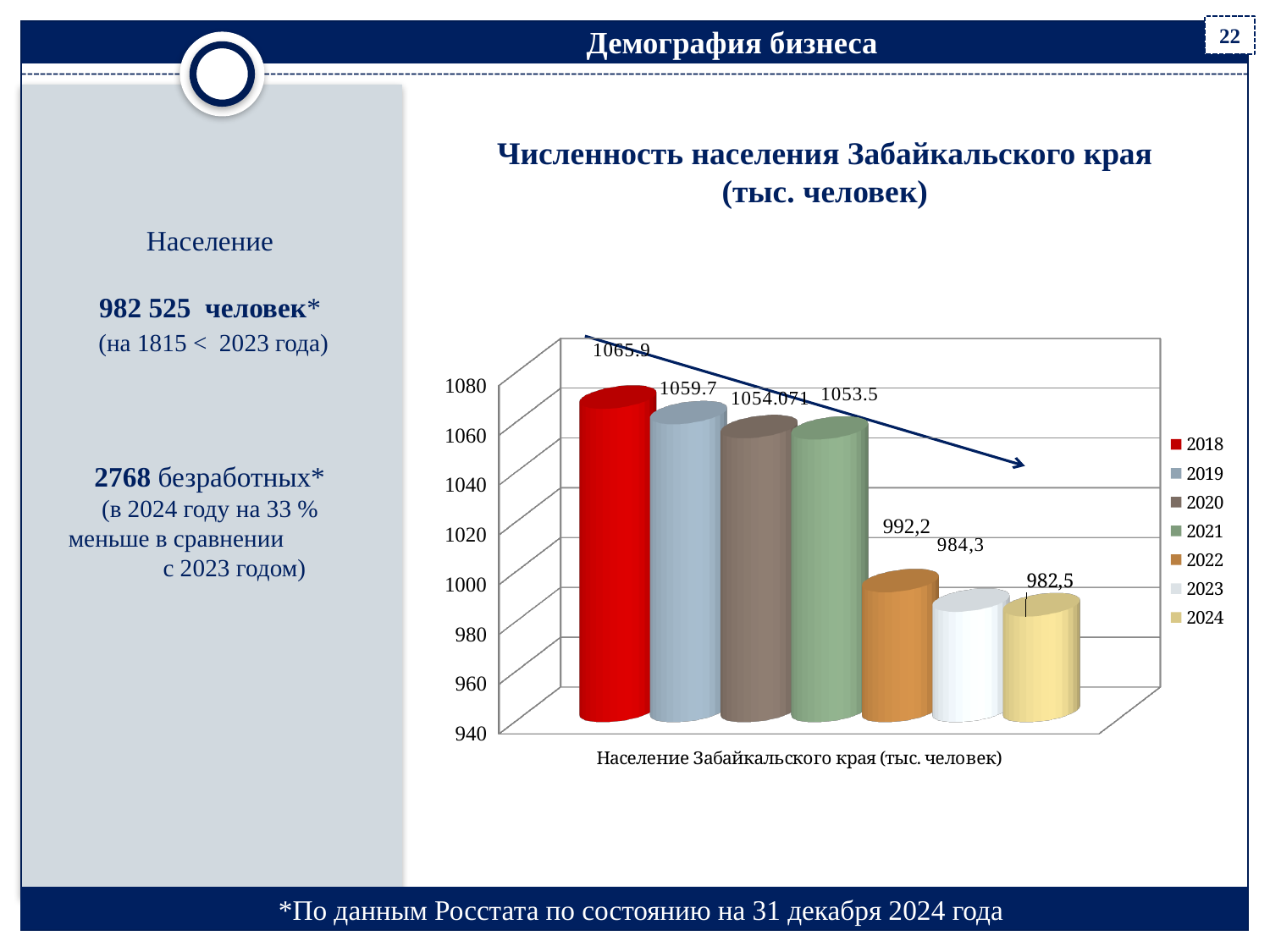
Which is larger, the value for 2019 or the value for 2023? 2019 What is the population value shown for 2022? 992,2 Do the population values rise or fall from 2018 to 2024? fall What is the title of the chart? Численность населения Забайкальского края (тыс. человек) Which year has the highest population value in the chart? 2018 Is the value for 2021 greater or less than 1040? greater What is the population value shown for 2020? 1054.071 What type of chart is shown on the slide? bar chart What is the population value shown for 2024? 982,5 How many series does the legend list? 7 What is the population value shown for 2018? 1065.9 Which year has the lowest population value in the chart? 2024